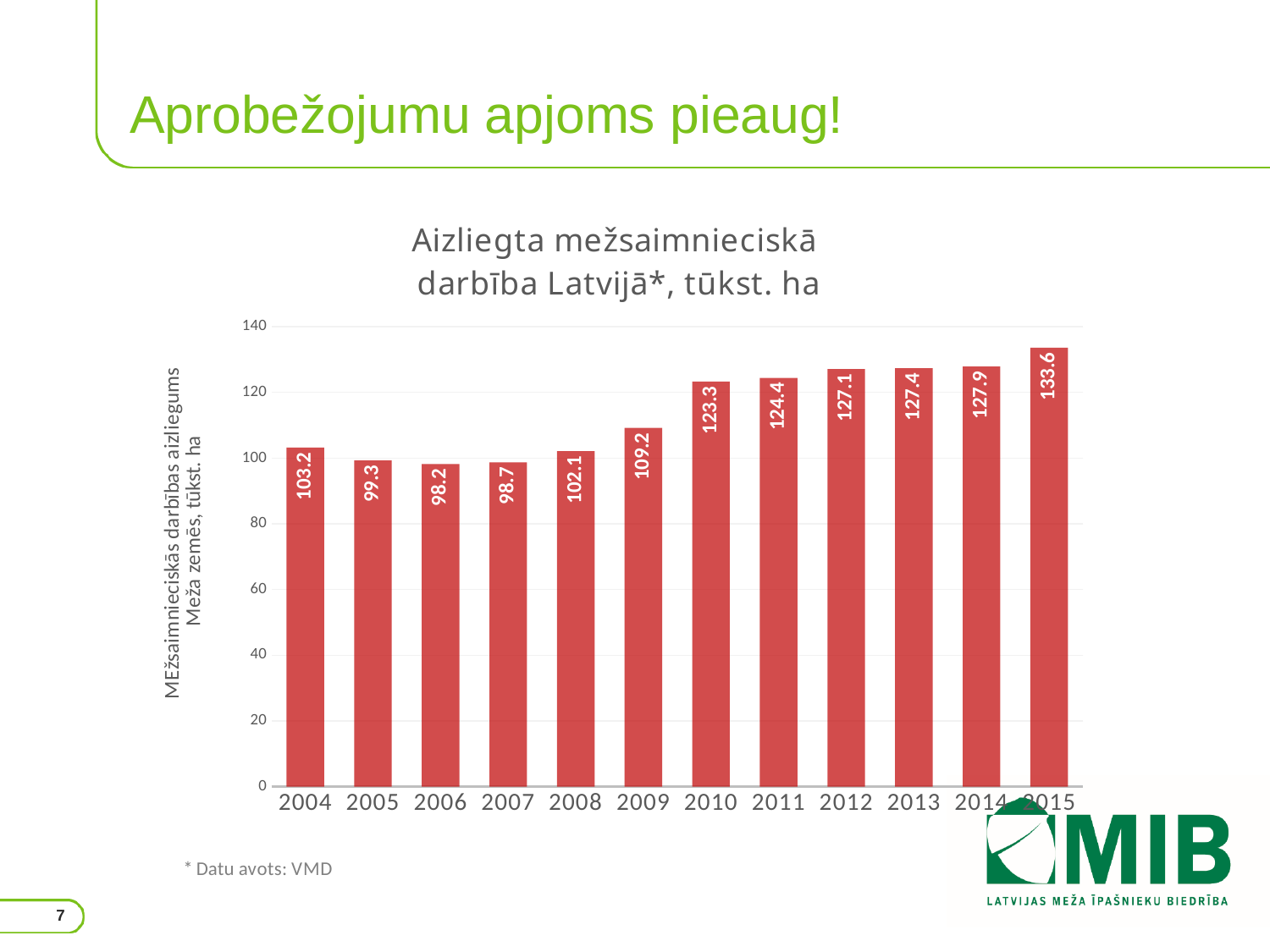
Which year has the lowest value? 2006 How many years are shown on the x axis? 12 What is the value for 2009? 109.2 Is the value for 2012 greater or less than 120? greater Do the values generally rise or fall from 2006 to 2015? rise What is the value for 2004? 103.2 What is the title of the chart? Aizliegta mežsaimnieciskā darbība Latvijā*, tūkst. ha What kind of chart is shown on the slide? bar chart Which year has the highest value? 2015 Which is larger, the value for 2010 or the value for 2008? 2010 What is the value for 2015? 133.6 What is the difference between the values for 2015 and 2004? 30.4